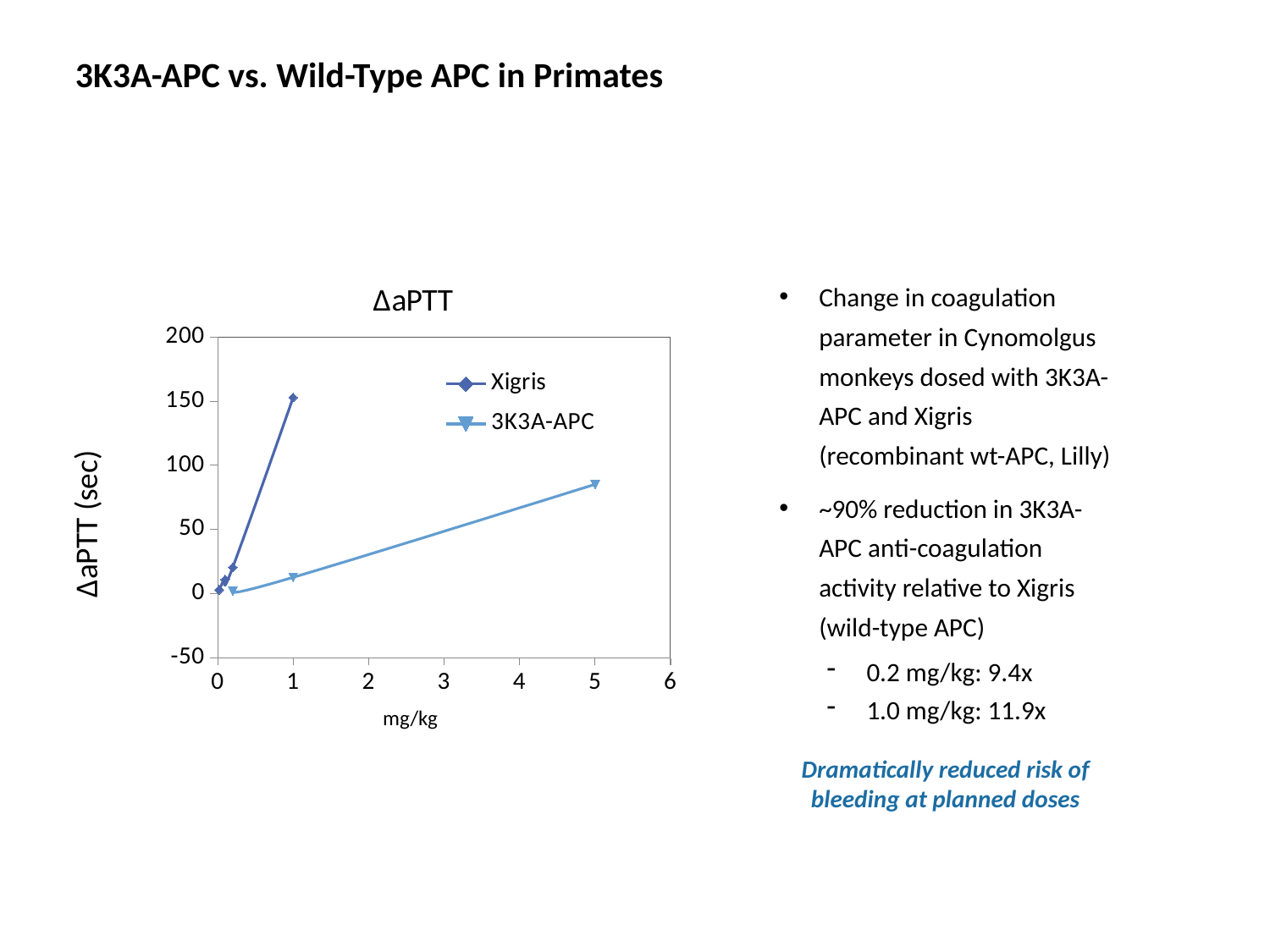
Is the ΔaPTT value for 3K3A-APC at 1 mg/kg greater or less than 50? less Do the ΔaPTT values for 3K3A-APC rise or fall as the dose in mg/kg increases? rise Is the ΔaPTT value for 3K3A-APC at 5 mg/kg greater or less than 50? greater What is the label of the x axis of the chart? mg/kg Is the ΔaPTT value for Xigris at 1 mg/kg greater or less than 100? greater How many series does the chart legend list? 2 Which series reaches the highest ΔaPTT value on the chart? Xigris Do the ΔaPTT values for Xigris rise or fall as the dose in mg/kg increases? rise What is the title of the chart? ΔaPTT At 1 mg/kg, which series has the larger ΔaPTT value, Xigris or 3K3A-APC? Xigris What type of chart is shown on the slide? line chart